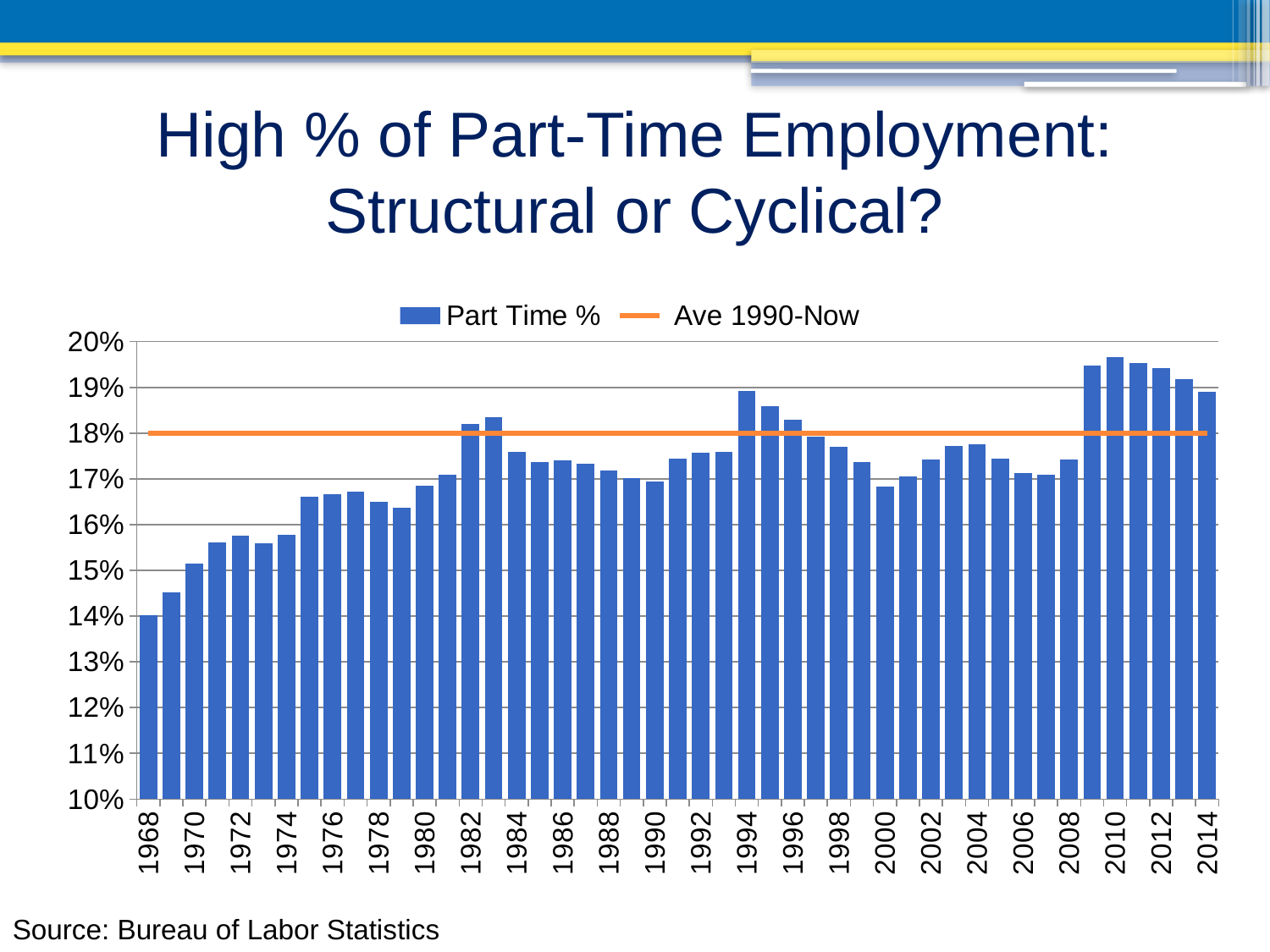
Is the Part Time % value for 1994 greater or less than 18%? greater Is the Part Time % value for 2000 greater or less than 17%? less Is the Part Time % value for 2010 greater or less than 19%? greater Which year has the larger Part Time % bar, 1990 or 1994? 1994 At what value does the orange Ave 1990-Now line sit on the vertical axis? 18% How many series does the legend list? 2 What kind of chart is shown on the slide? Combination bar and line chart Which year has the lowest Part Time % bar? 1968 Do the Part Time % bars rise or fall from 1968 to 1975? Rise Which year has the larger Part Time % bar, 2000 or 2009? 2009 What are the two entries in the chart legend? Part Time % and Ave 1990-Now